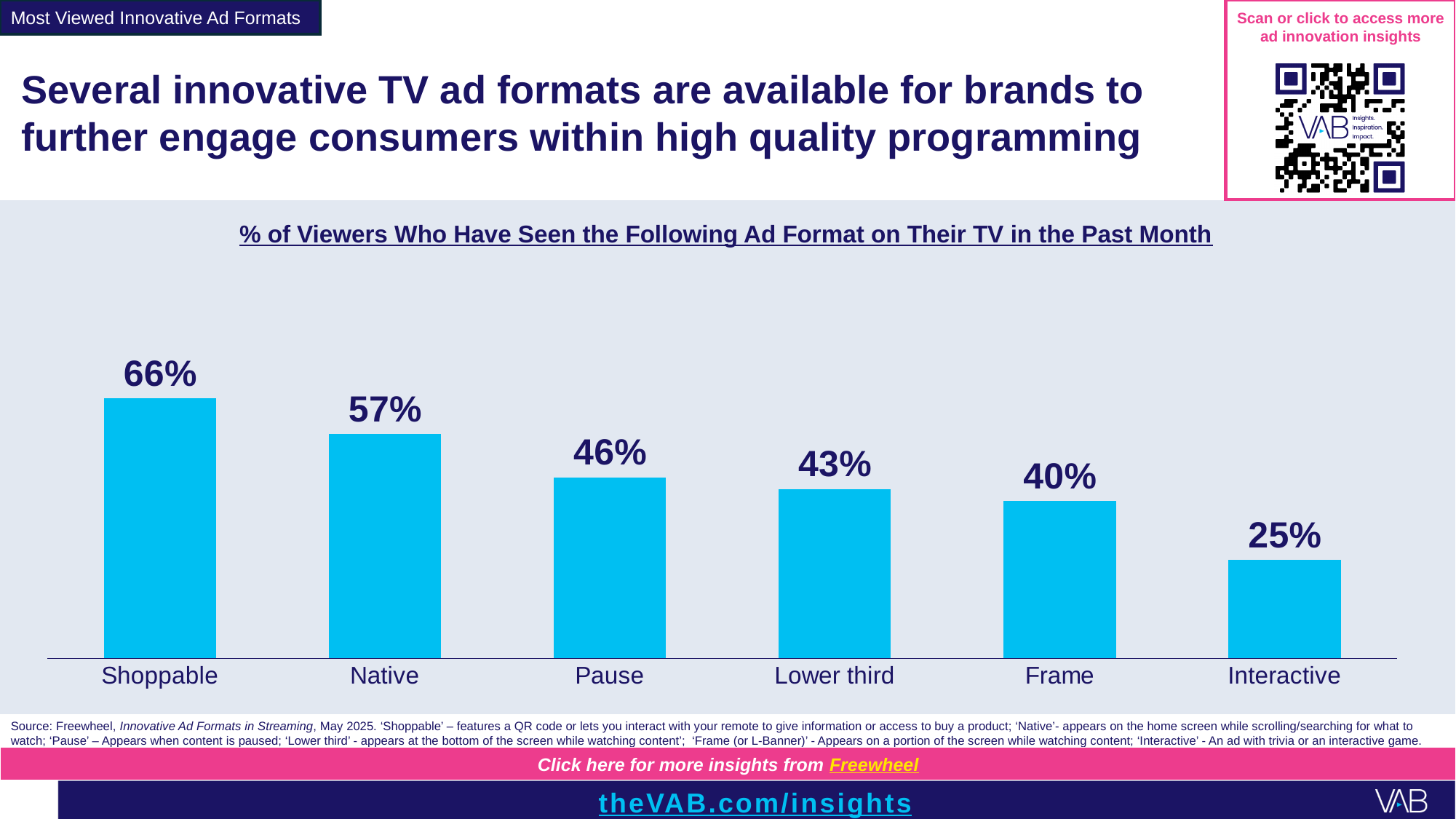
What is the difference in percentage points between Frame and Interactive? 15 Which ad format has the highest percentage of viewers who have seen it? Shoppable What is the value shown for the Pause ad format? 46% What percentage of viewers have seen a Shoppable ad format on their TV in the past month? 66% How many ad formats are shown in the chart? 6 Which ad format has the lowest percentage of viewers who have seen it? Interactive What is the title of the chart? % of Viewers Who Have Seen the Following Ad Format on Their TV in the Past Month What is the difference in percentage points between Shoppable and Native? 9 What percentage of viewers have seen the Lower third ad format? 43% Which has a higher value, Native or Pause? Native What type of chart is used on this slide? Bar chart Do the values rise or fall moving from left to right across the chart? Fall